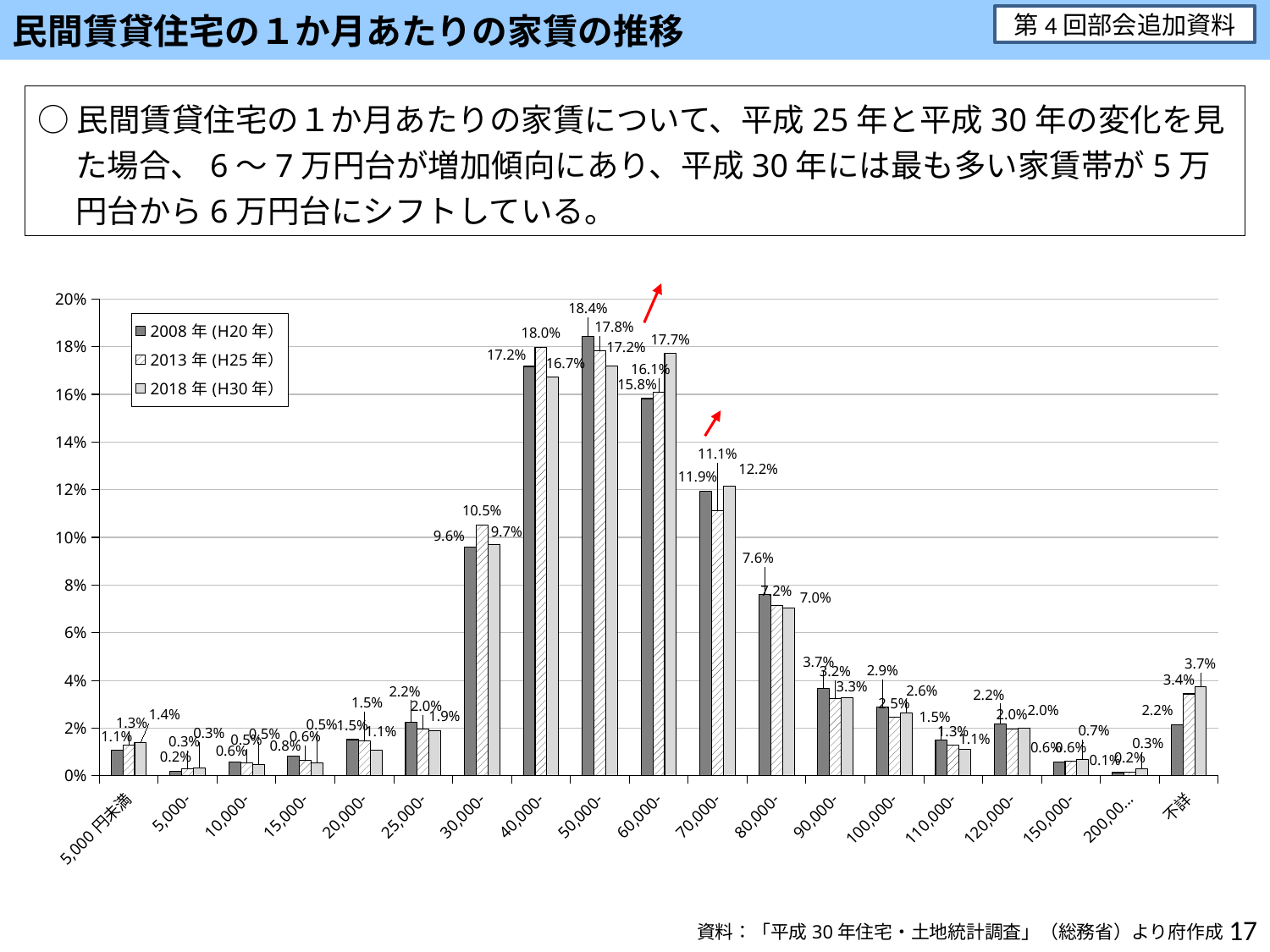
What is the value for 2018年(H30年) in the 60,000- category? 17.7% How many series does the legend list? 3 What is the difference between the 2018年(H30年) and 2008年(H20年) values in the 60,000- category? 1.9% What is the value for 2018年(H30年) in the 不詳 category? 3.7% What is the value for 2013年(H25年) in the 30,000- category? 10.5% Which category has the highest value for the 2018年(H30年) series? 60,000- What is the value for 2008年(H20年) in the 50,000- category? 18.4% What kind of chart is shown on the slide? Bar chart Which is larger in the 70,000- category: the 2013年(H25年) value or the 2018年(H30年) value? 2018年(H30年) What is the title of the slide containing the chart? 民間賃貸住宅の１か月あたりの家賃の推移 How many rent categories are shown on the x axis? 19 Which category has the highest value for the 2008年(H20年) series? 50,000-